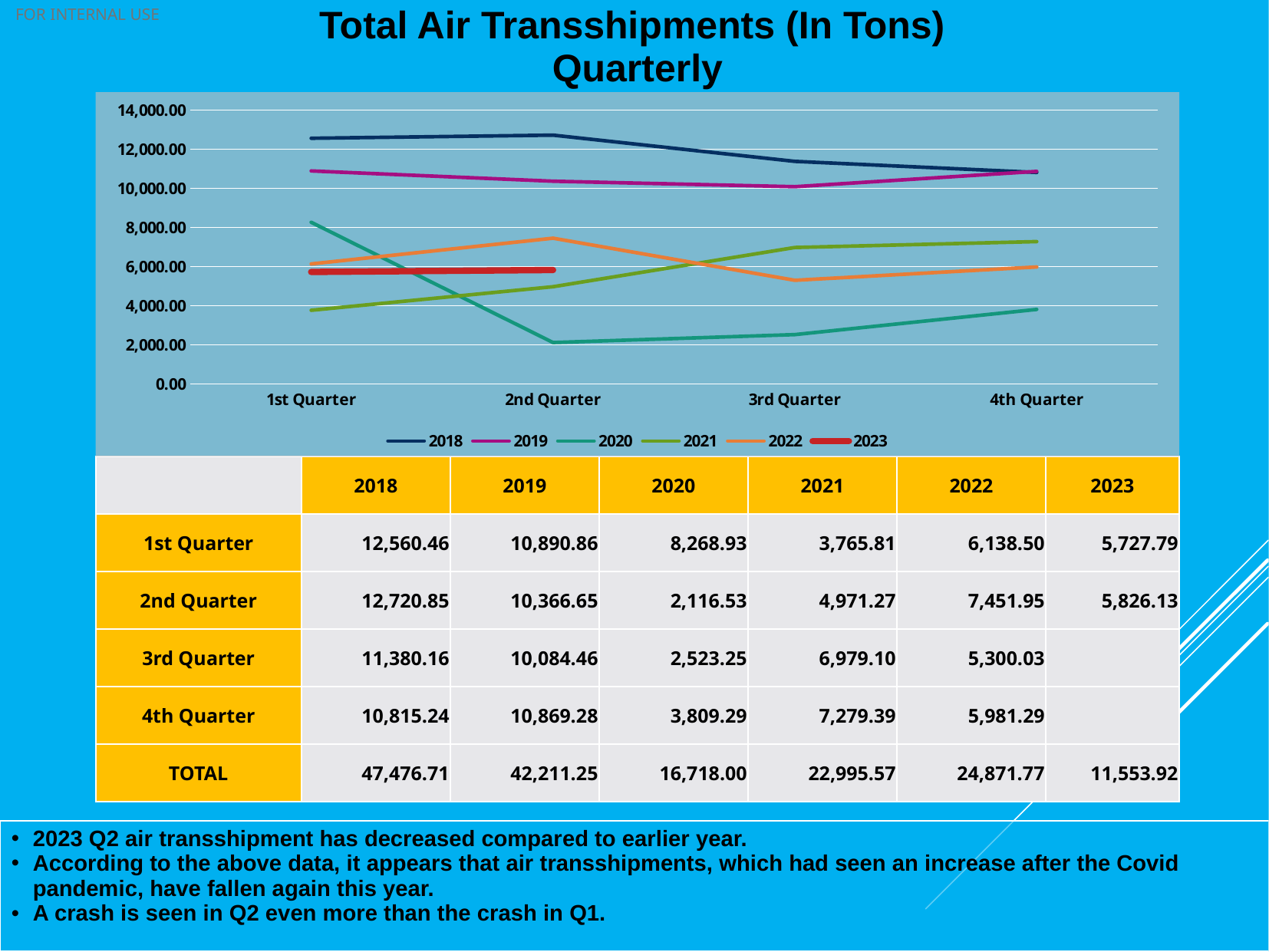
What is the value for 2018 in the 2nd Quarter? 12,720.85 Is the value for 2022 in the 2nd Quarter greater or less than 6,000.00? greater How many series does the legend list? 6 How many quarters are plotted along the x axis? 4 Does the 2021 series rise or fall from the 1st Quarter to the 4th Quarter? rise What kind of chart is shown on the slide? line chart What is the difference between the 2022 and 2023 values in the 2nd Quarter? 1,625.82 What is the value for 2020 in the 2nd Quarter? 2,116.53 Which year has the highest value in the 1st Quarter? 2018 In which quarter does the 2020 series reach its lowest value? 2nd Quarter Which series is drawn with the thick red line? 2023 Which is larger in the 4th Quarter, the value for 2021 or the value for 2022? 2021